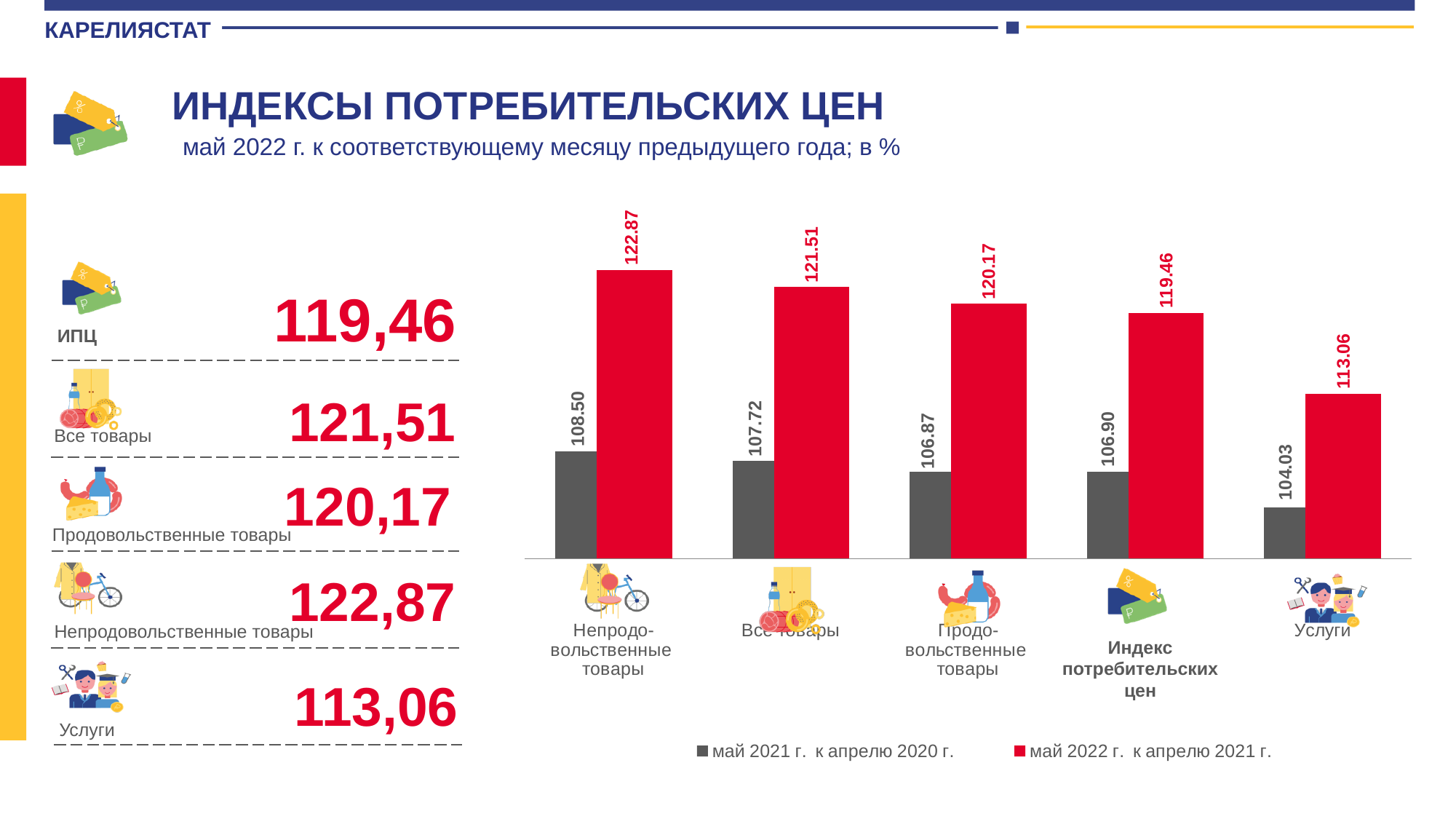
What colour are the bars for the series 'май 2022 г. к апрелю 2021 г.'? red How many categories are plotted on the chart? 5 What is the difference between the 'май 2022 г. к апрелю 2021 г.' and 'май 2021 г. к апрелю 2020 г.' values for Все товары? 13.79 What is the value for Продовольственные товары in the series 'май 2021 г. к апрелю 2020 г.'? 106.87 Which category has the lowest value in the series 'май 2021 г. к апрелю 2020 г.'? Услуги Do the values in the series 'май 2022 г. к апрелю 2021 г.' rise or fall from left to right across the categories? fall What is the value for Индекс потребительских цен in the series 'май 2022 г. к апрелю 2021 г.'? 119.46 Which is larger: the 'май 2022 г. к апрелю 2021 г.' value for Услуги or for Продовольственные товары? Продовольственные товары What is the value for Услуги in the series 'май 2022 г. к апрелю 2021 г.'? 113.06 What type of chart is shown on the slide? bar chart Which category has the highest value in the series 'май 2022 г. к апрелю 2021 г.'? Непродовольственные товары How many series does the chart legend list? 2